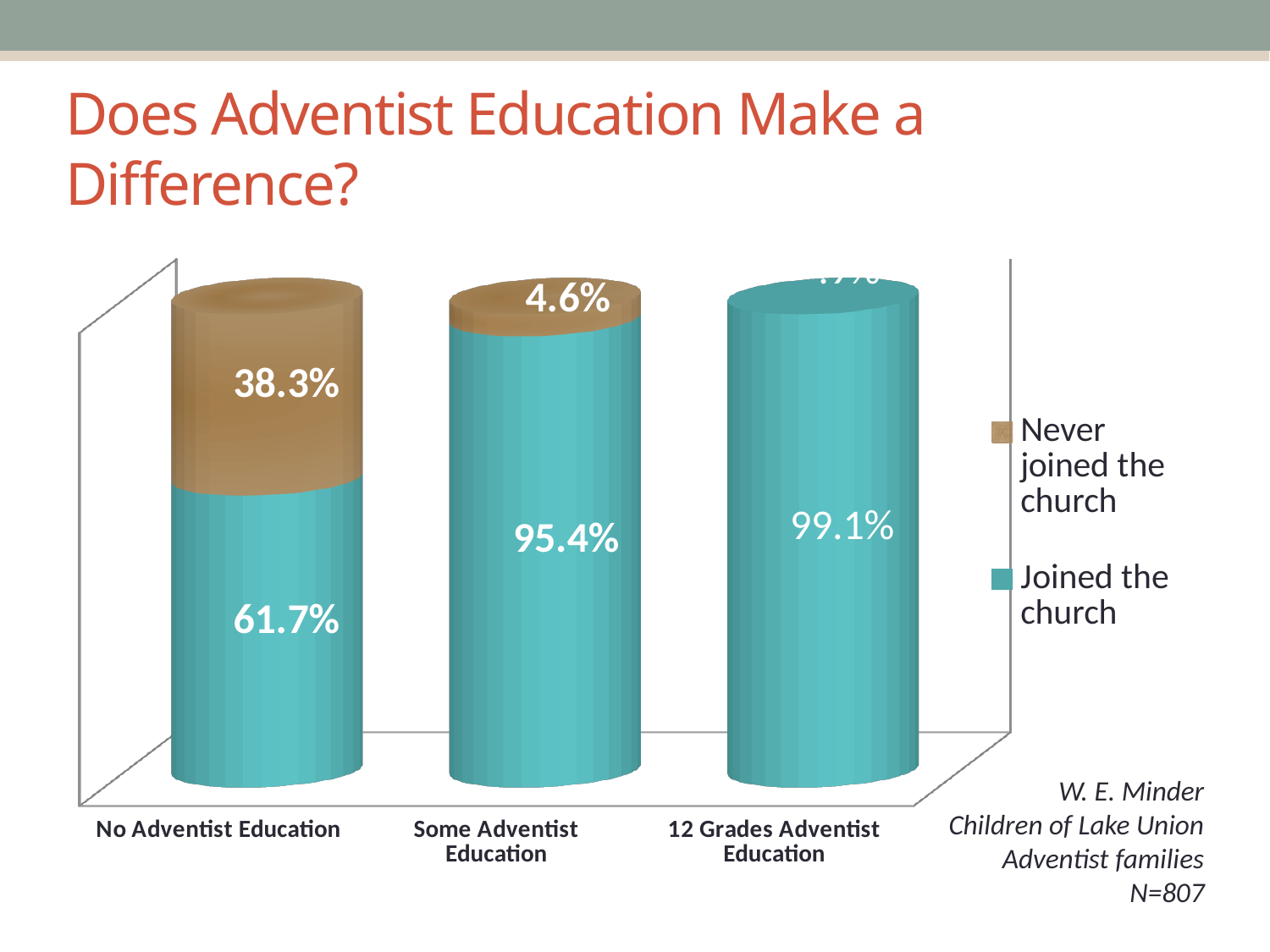
How many education categories are shown on the x axis? 3 Which category has the highest 'Joined the church' percentage? 12 Grades Adventist Education What percentage of children with No Adventist Education never joined the church? 38.3% What is the 'Joined the church' value for 12 Grades Adventist Education? 99.1% How many percentage points higher is the 'Joined the church' value for Some Adventist Education than for No Adventist Education? 33.7 percentage points Does the 'Joined the church' percentage rise or fall as you move from No Adventist Education to 12 Grades Adventist Education? rise What percentage of children with No Adventist Education joined the church? 61.7% What is the 'Joined the church' value for Some Adventist Education? 95.4% Which category has the lowest 'Joined the church' percentage? No Adventist Education Which has a larger 'Never joined the church' share: No Adventist Education or Some Adventist Education? No Adventist Education How many series does the legend list? 2 What is the 'Never joined the church' value for Some Adventist Education? 4.6%